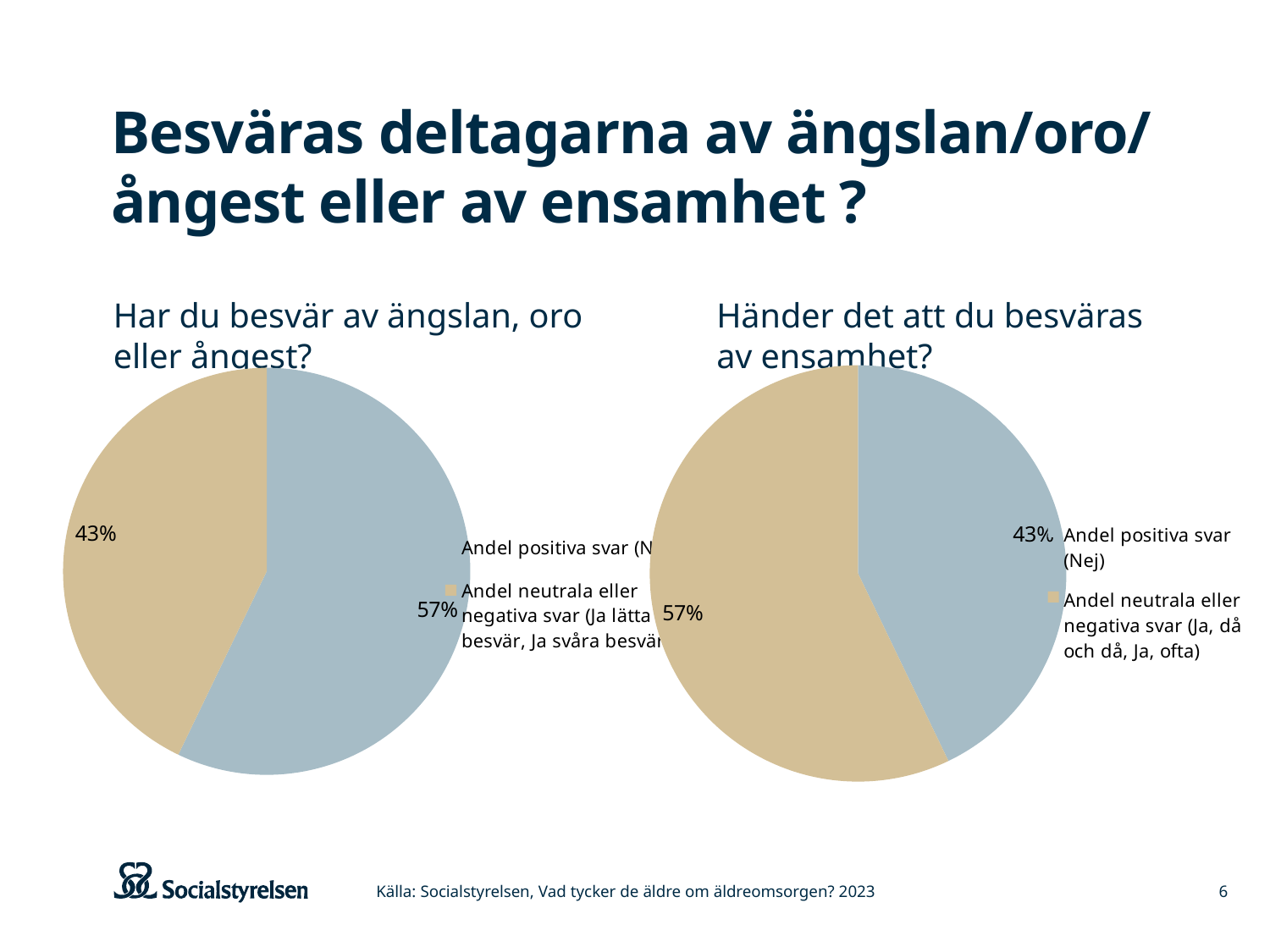
In the right chart 'Händer det att du besväras av ensamhet?', what share is 'Andel neutrala eller negativa svar (Ja, då och då, Ja, ofta)'? 57% In the left chart 'Har du besvär av ängslan, oro eller ångest?', what share is 'Andel neutrala eller negativa svar'? 43% In the left chart 'Har du besvär av ängslan, oro eller ångest?', which slice is the largest? Andel positiva svar How many slices does each pie chart have? 2 In the left chart 'Har du besvär av ängslan, oro eller ångest?', what share is 'Andel positiva svar'? 57% In the right chart 'Händer det att du besväras av ensamhet?', which slice is the smallest? Andel positiva svar (Nej) How many pie charts are on the slide? 2 What kind of charts are shown on the slide? Pie charts In the right chart 'Händer det att du besväras av ensamhet?', which is larger: the positive slice or the neutral/negative slice? The neutral/negative slice In the right chart 'Händer det att du besväras av ensamhet?', what share is 'Andel positiva svar (Nej)'? 43% In the left chart 'Har du besvär av ängslan, oro eller ångest?', what is the difference in percentage points between the positive and the neutral/negative slices? 14 percentage points In the right chart 'Händer det att du besväras av ensamhet?', what colour is the 'Andel positiva svar (Nej)' slice? Blue